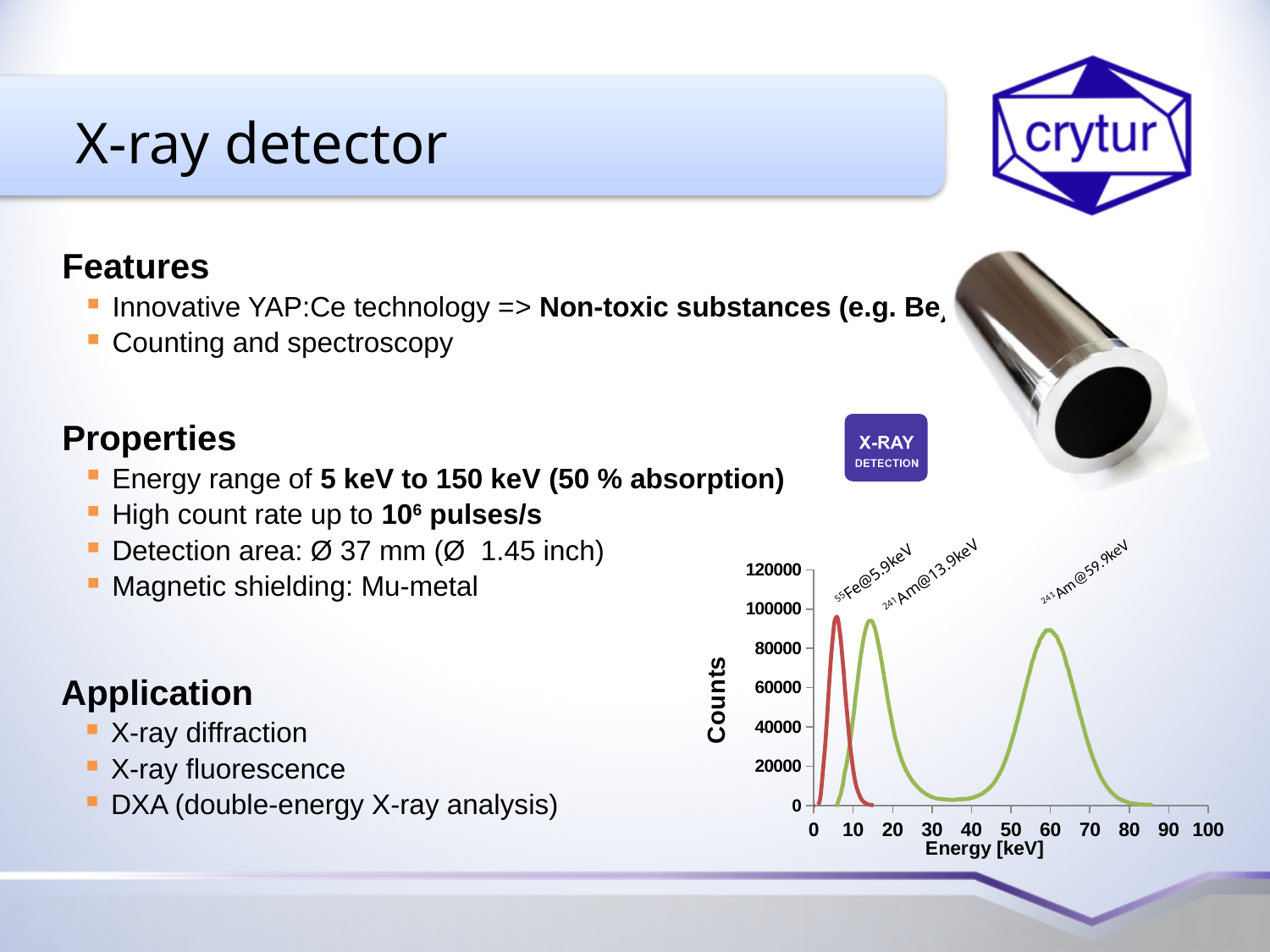
What is the highest value shown on the y axis of the chart? 120000 Is the peak value of the 241Am@59.9keV peak greater or less than 80000 counts? greater Is the peak value of the 55Fe@5.9keV line greater or less than 100000 counts? less How many labelled peaks are marked on the chart? 3 What is the label of the x axis of the chart? Energy [keV] How many differently coloured lines are plotted on the chart? 2 What is the label of the y axis of the chart? Counts Is the count value of the green line at 40 keV greater or less than 20000? less What kind of chart is shown on the slide? line chart At approximately which energy does the 241Am@59.9keV peak occur, according to its label? 59.9keV